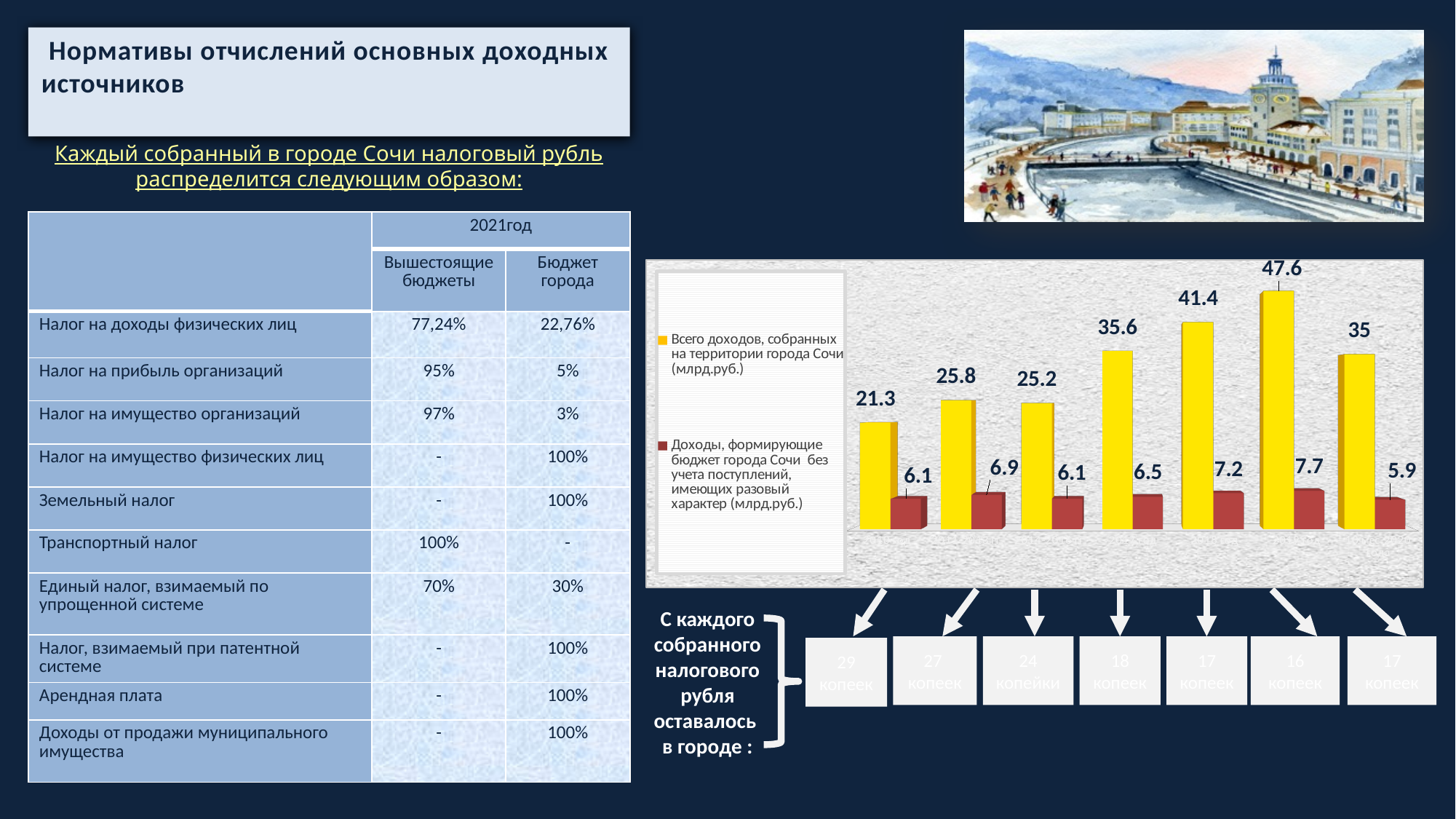
In the bar chart, what is the highest value of the yellow series (Всего доходов, собранных на территории города Сочи)? 47.6 In the bar chart, which is larger: the yellow bar in the fifth group or the yellow bar in the seventh group? the fifth group (41.4) In the bar chart, what is the lowest value of the red series (Доходы, формирующие бюджет города Сочи)? 5.9 What kind of chart is shown on the right side of the slide? bar chart How many series does the legend of the bar chart list? 2 In the bar chart, what is the lowest value of the yellow series (Всего доходов, собранных на территории города Сочи)? 21.3 In the bar chart, what is the value of the yellow bar in the first (leftmost) group? 21.3 In the bar chart, what is the value of the red bar in the last (rightmost) group? 5.9 In the bar chart, what is the difference between the yellow and red bars in the sixth group (47.6 and 7.7)? 39.9 In the bar chart, what colour are the bars for the series 'Всего доходов, собранных на территории города Сочи (млрд.руб.)'? yellow How many groups of bars are plotted in the bar chart? 7 In the bar chart, what is the highest value of the red series (Доходы, формирующие бюджет города Сочи)? 7.7